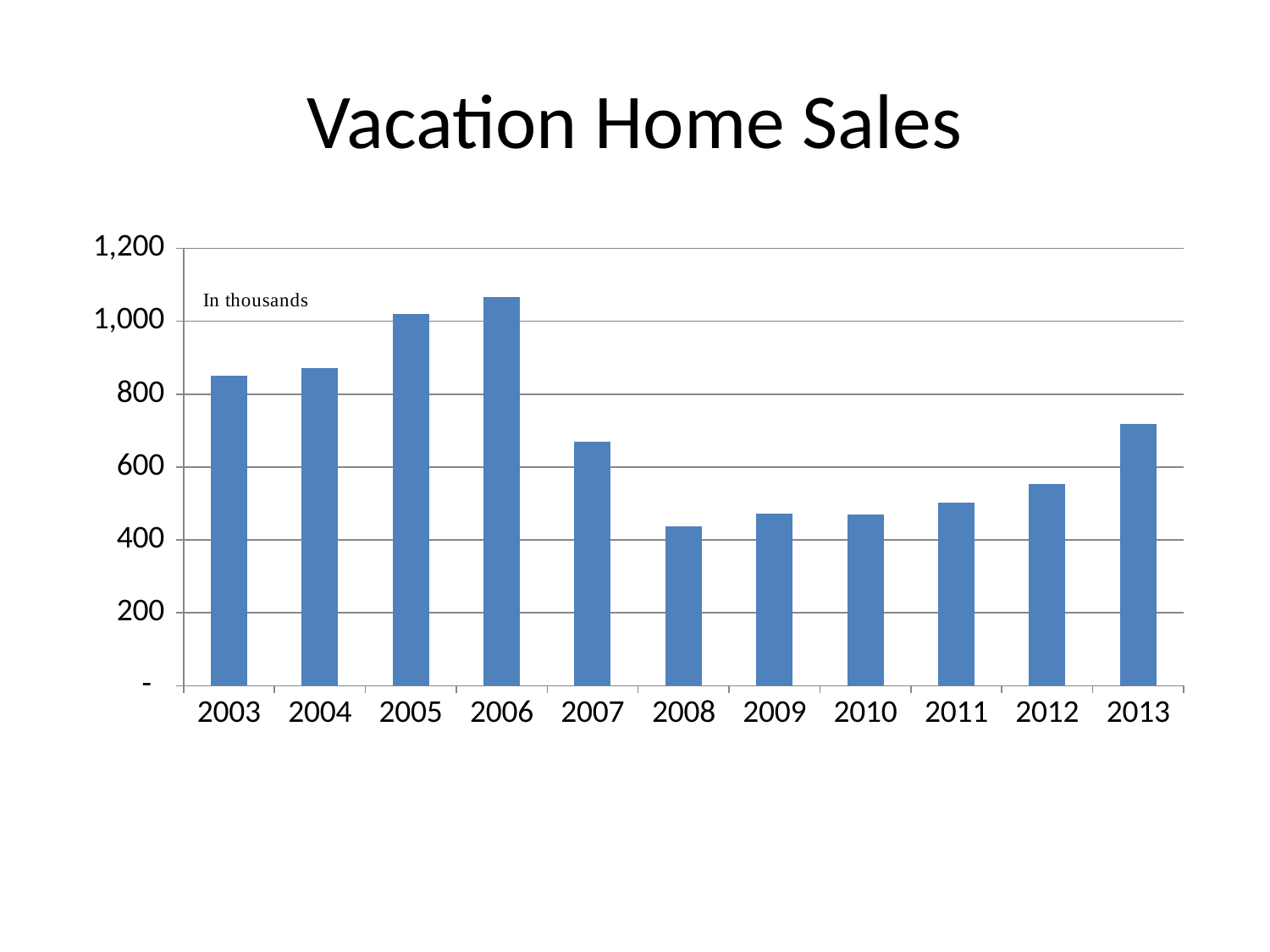
What is the title of the chart? Vacation Home Sales Is the value for 2012 greater or less than 600? less How many years are shown on the x axis of the chart? 11 In what units are the values on the chart expressed, according to the note inside the plot area? In thousands Which year has higher vacation home sales, 2005 or 2007? 2005 Is the value for 2008 greater or less than 400? greater Which year has the highest vacation home sales? 2006 What kind of chart is shown on the slide? Bar chart Do vacation home sales rise or fall from 2006 to 2008? Fall Is the value for 2005 greater or less than 1,000? greater Which year has the lowest vacation home sales? 2008